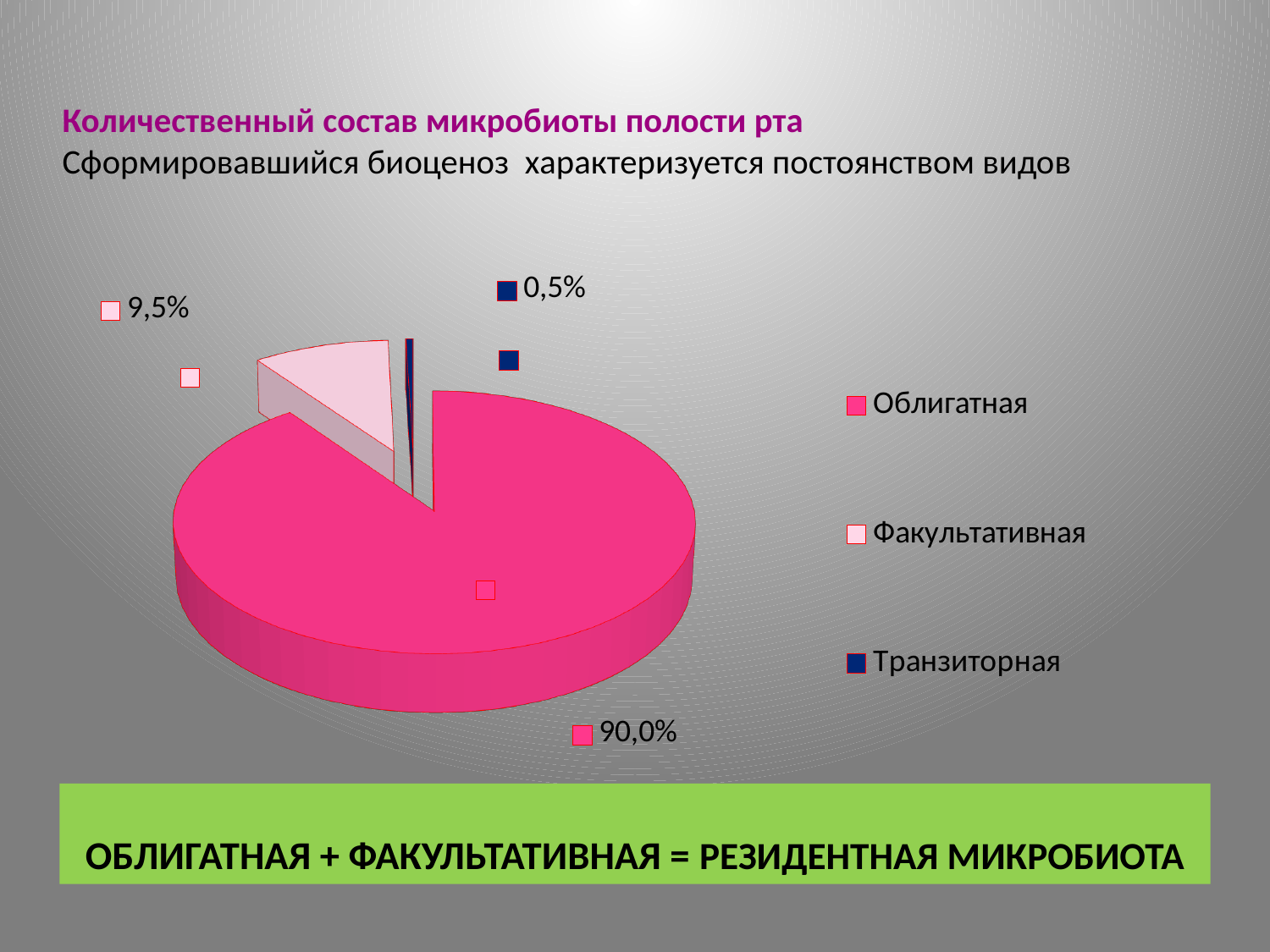
What is the difference between the shares of Факультативная and Транзиторная? 9,0% What is the difference between the shares of Облигатная and Факультативная? 80,5% Which is larger, the share of Факультативная or the share of Транзиторная? Факультативная What share of the pie does Факультативная take? 9,5% How many entries does the legend list? 3 What kind of chart is shown on the slide? pie chart What share of the pie does Транзиторная take? 0,5% Which category has the smallest slice of the pie? Транзиторная How many slices does the pie chart have? 3 What share of the pie does Облигатная take? 90,0% Which category has the largest slice of the pie? Облигатная What colour is the Транзиторная slice in the legend? dark blue